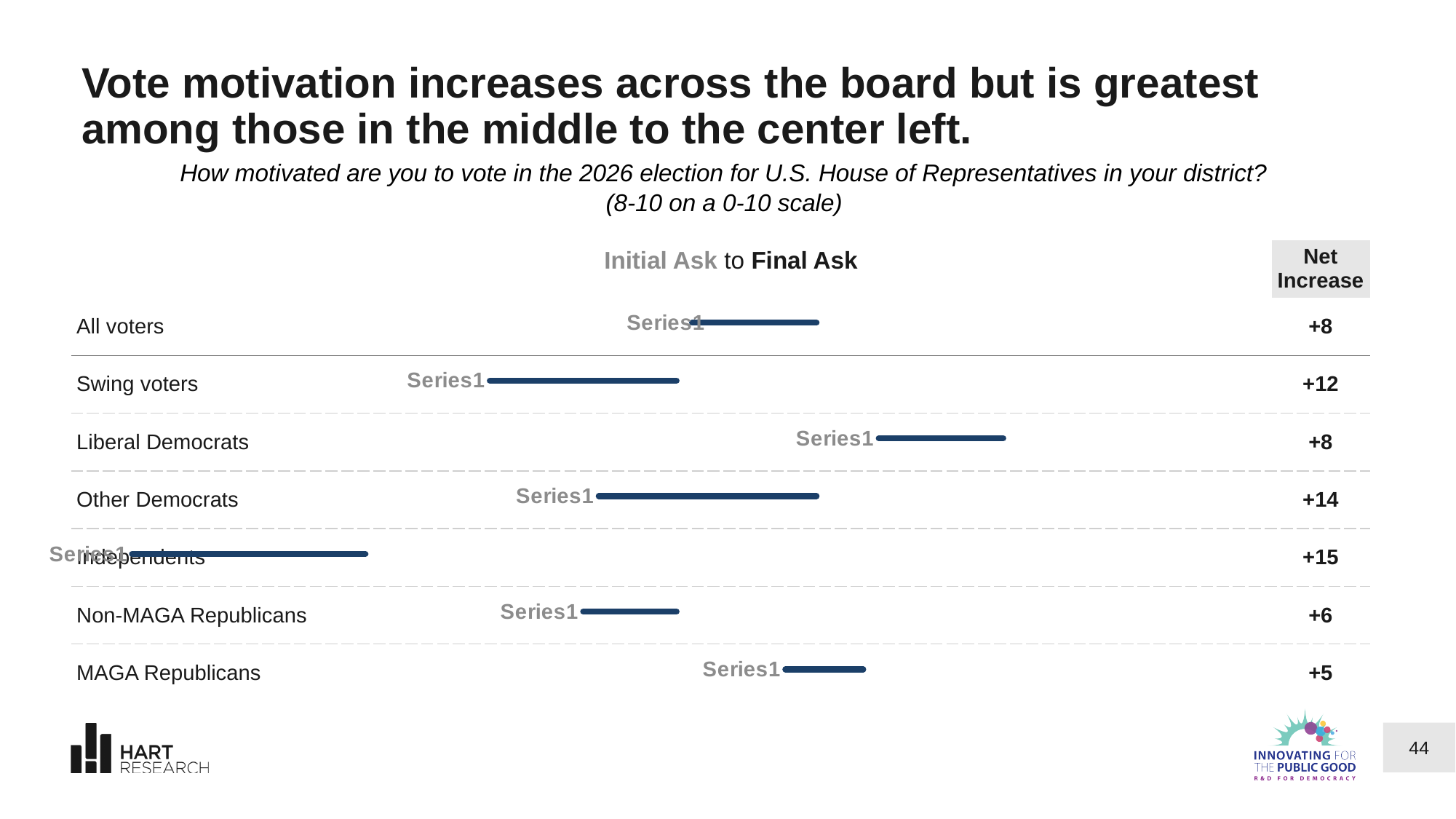
Which group has the smallest net increase in vote motivation? MAGA Republicans How much larger is the net increase for Independents than for Non-MAGA Republicans? 9 What is the net increase in vote motivation for Swing voters? +12 What is the net increase shown for MAGA Republicans? +5 What is the net increase shown for Independents? +15 What is the net increase shown for All voters? +8 How many voter groups are shown in the chart? 7 What is the net increase shown for Other Democrats? +14 Which group has the largest net increase in vote motivation? Independents Which has a larger net increase, Swing voters or Liberal Democrats? Swing voters What kind of chart is used to show the change from Initial Ask to Final Ask? Bar chart What is the heading of the column on the right side of the chart? Net Increase